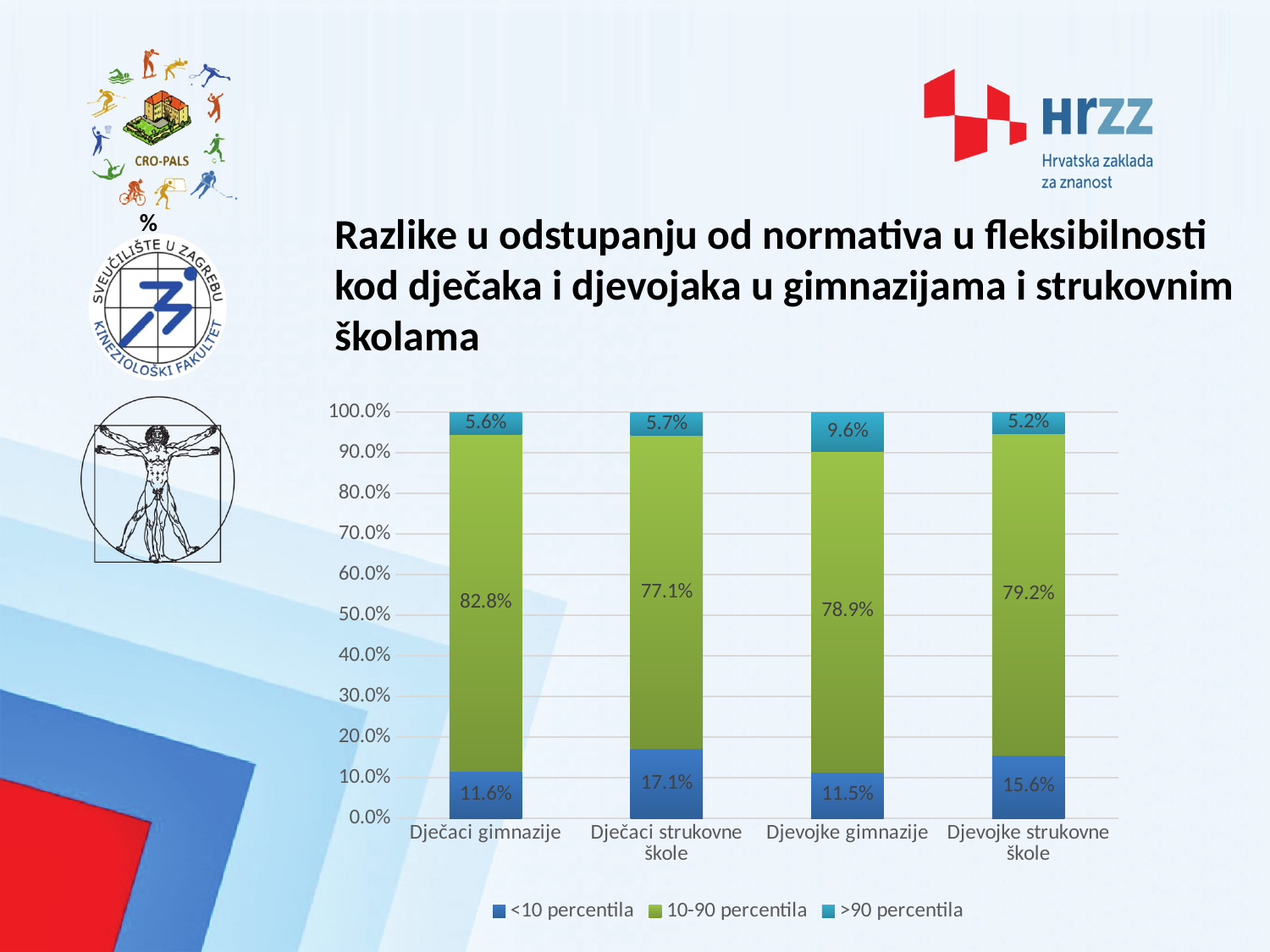
What type of chart is shown on the slide? stacked bar chart How many series does the legend list? 3 What is the difference between the '<10 percentila' values for 'Dječaci strukovne škole' and 'Djevojke strukovne škole'? 1.5% What is the title of the chart on the slide? Razlike u odstupanju od normativa u fleksibilnosti kod dječaka i djevojaka u gimnazijama i strukovnim školama How many categories are shown on the x axis? 4 What is the value of the '10-90 percentila' series for 'Dječaci gimnazije'? 82.8% Which is larger: the '10-90 percentila' value for 'Djevojke gimnazije' or for 'Djevojke strukovne škole'? Djevojke strukovne škole What is the total of the stacked bar for 'Dječaci gimnazije'? 100.0% What is the value of the '>90 percentila' series for 'Djevojke gimnazije'? 9.6% Which category has the highest value for the '>90 percentila' series? Djevojke gimnazije What is the value of the '<10 percentila' series for 'Dječaci strukovne škole'? 17.1% Which category has the lowest value for the '10-90 percentila' series? Dječaci strukovne škole